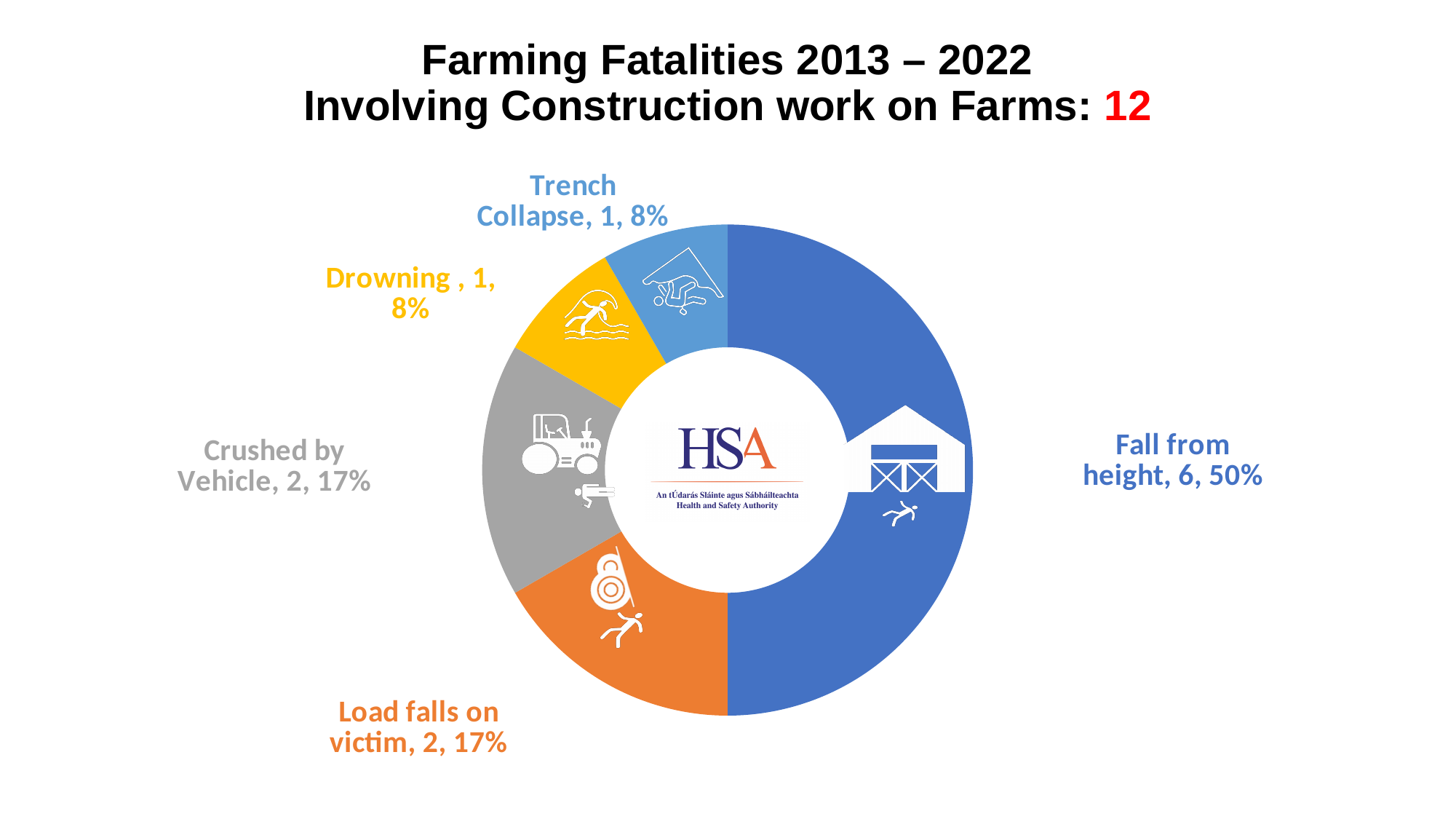
What is the title of the chart? Farming Fatalities 2013 – 2022 Involving Construction work on Farms: 12 What share of the fatalities is Crushed by Vehicle? 17% Which is larger, Crushed by Vehicle or Drowning? Crushed by Vehicle How many fatalities are attributed to Drowning? 1 Which category has the highest number of fatalities? Fall from height What is the difference in fatalities between Fall from height and Load falls on victim? 4 How many fatalities are attributed to Fall from height? 6 How many categories does the chart show? 5 What is the total number of fatalities shown in the chart title? 12 What share of the fatalities is Fall from height? 50% What kind of chart is shown on the slide? Pie chart (doughnut) What share of the fatalities is Trench Collapse? 8%